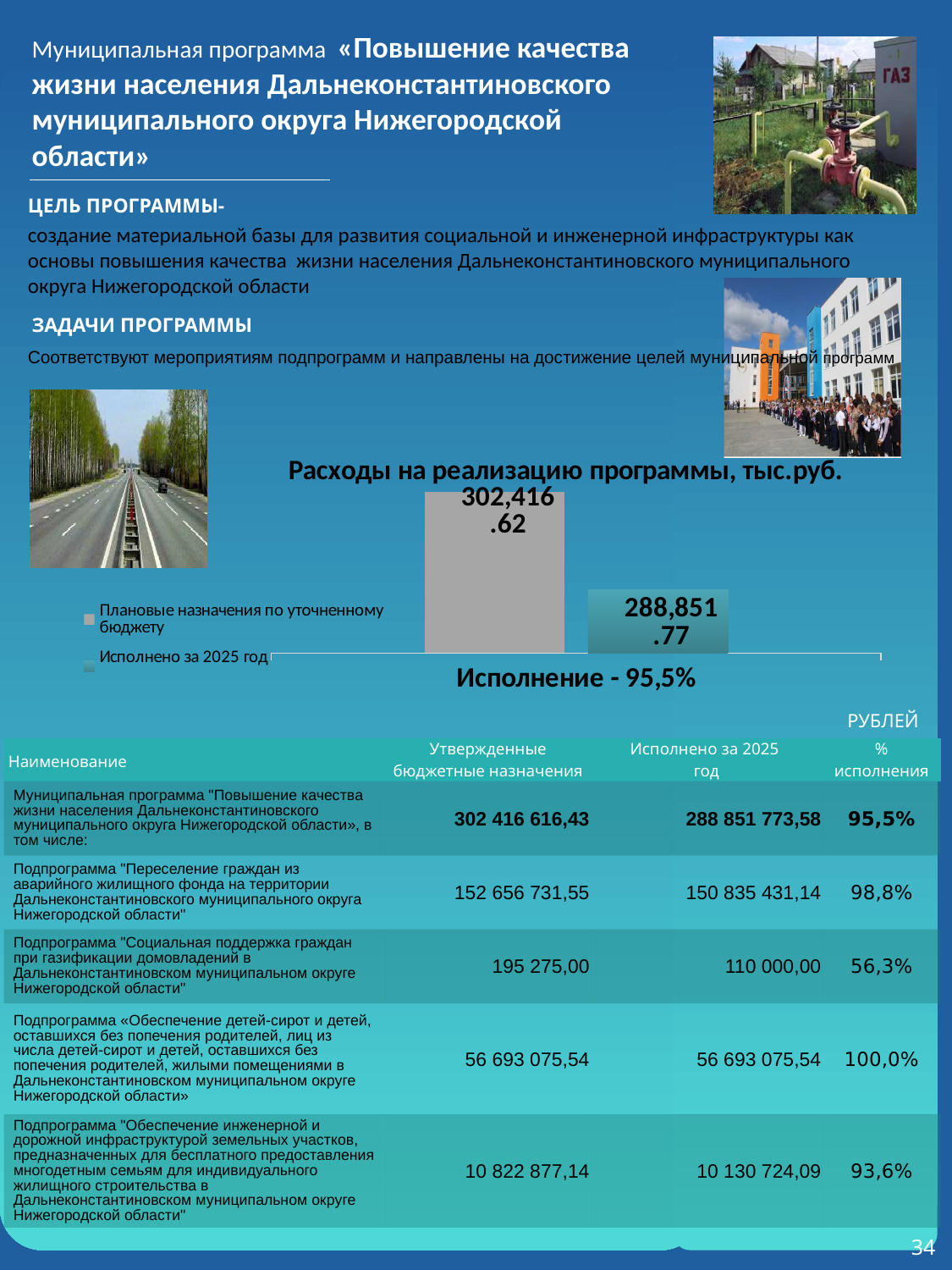
What is the title of the chart on the slide? Расходы на реализацию программы, тыс.руб. What is the value of the bar for 'Плановые назначения по уточненному бюджету' in the chart 'Расходы на реализацию программы, тыс.руб.'? 302,416.62 How many series does the legend of the chart 'Расходы на реализацию программы, тыс.руб.' list? 2 What type of chart is 'Расходы на реализацию программы, тыс.руб.'? bar chart How many bars are plotted in the chart 'Расходы на реализацию программы, тыс.руб.'? 2 What execution percentage is printed below the chart 'Расходы на реализацию программы, тыс.руб.'? 95,5% What is the difference between the planned value (302,416.62) and the executed value (288,851.77) in the chart 'Расходы на реализацию программы, тыс.руб.'? 13,564.85 What is the value of the bar for 'Исполнено за 2025 год' in the chart 'Расходы на реализацию программы, тыс.руб.'? 288,851.77 In the chart 'Расходы на реализацию программы, тыс.руб.', is the value for 'Плановые назначения по уточненному бюджету' larger or smaller than the value for 'Исполнено за 2025 год'? larger Which series has the higher value in the chart 'Расходы на реализацию программы, тыс.руб.'? Плановые назначения по уточненному бюджету Which series has the lower value in the chart 'Расходы на реализацию программы, тыс.руб.'? Исполнено за 2025 год